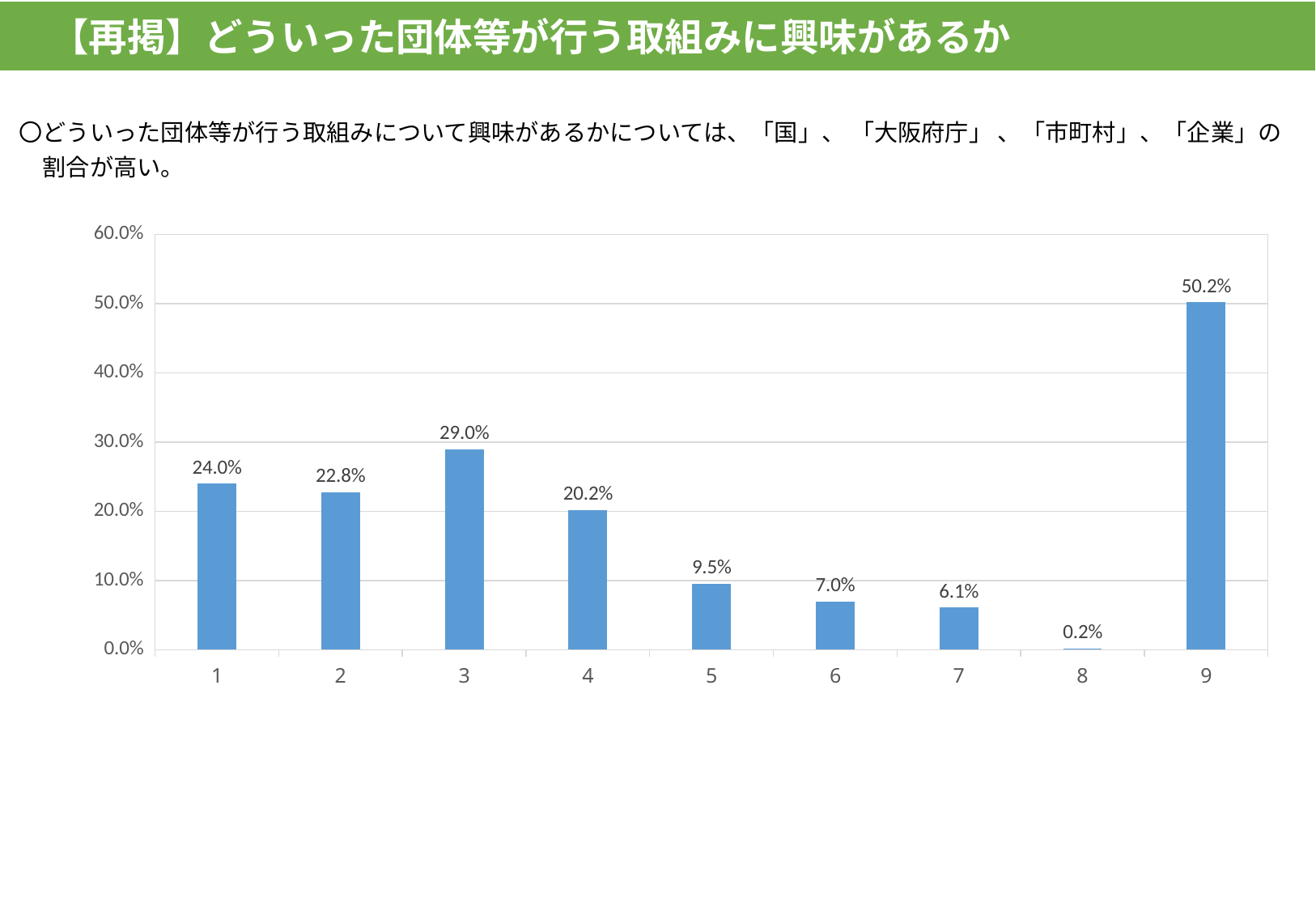
What is the value for category 8? 0.2% What is the value for category 9? 50.2% What kind of chart is shown on the slide? bar chart Which is larger, the value for category 4 or the value for category 5? 4 What is the value for category 3? 29.0% Which category has the lowest value? 8 What is the difference between the values for category 9 and category 3? 21.2% Is the value for category 9 greater or less than 40.0%? greater What is the highest value shown on the y axis? 60.0% Which category has the highest value? 9 How many categories are shown on the x axis? 9 What is the difference between the values for category 1 and category 2? 1.2%